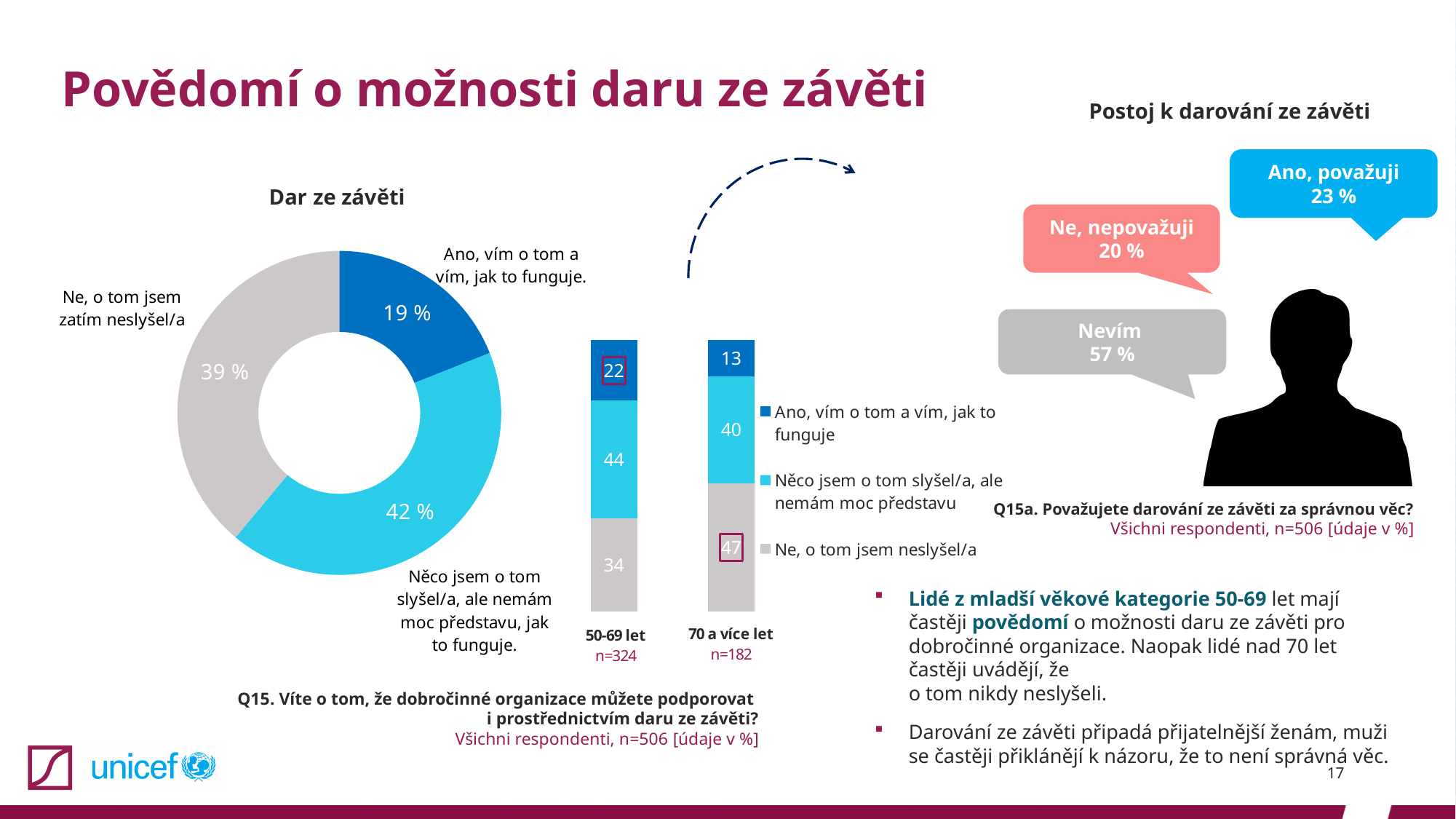
What type of chart is 'Dar ze závěti'? Donut chart In the 'Dar ze závěti' donut chart, what share is labelled 'Ne, o tom jsem zatím neslyšel/a'? 39 % In the 'Dar ze závěti' donut chart, which category has the smallest share? Ano, vím o tom a vím, jak to funguje. In the stacked bar chart by age group, what is the difference between the 'Ne, o tom jsem neslyšel/a' values for '70 a více let' and '50-69 let'? 13 In the stacked bar chart by age group, what is the total of the '70 a více let' bar? 100 In the stacked bar chart by age group, what is the value for 'Ano, vím o tom a vím, jak to funguje' in the '50-69 let' bar? 22 How many series does the legend of the stacked bar chart by age group list? 3 How many slices does the 'Dar ze závěti' donut chart have? 3 In the 'Dar ze závěti' donut chart, which category has the largest share? Něco jsem o tom slyšel/a, ale nemám moc představu, jak to funguje. In the stacked bar chart by age group, what is the value for 'Ne, o tom jsem neslyšel/a' in the '70 a více let' bar? 47 In the 'Dar ze závěti' donut chart, what share is labelled 'Ano, vím o tom a vím, jak to funguje.'? 19 % In the stacked bar chart by age group, which bar has the larger value for 'Něco jsem o tom slyšel/a, ale nemám moc představu': '50-69 let' or '70 a více let'? 50-69 let